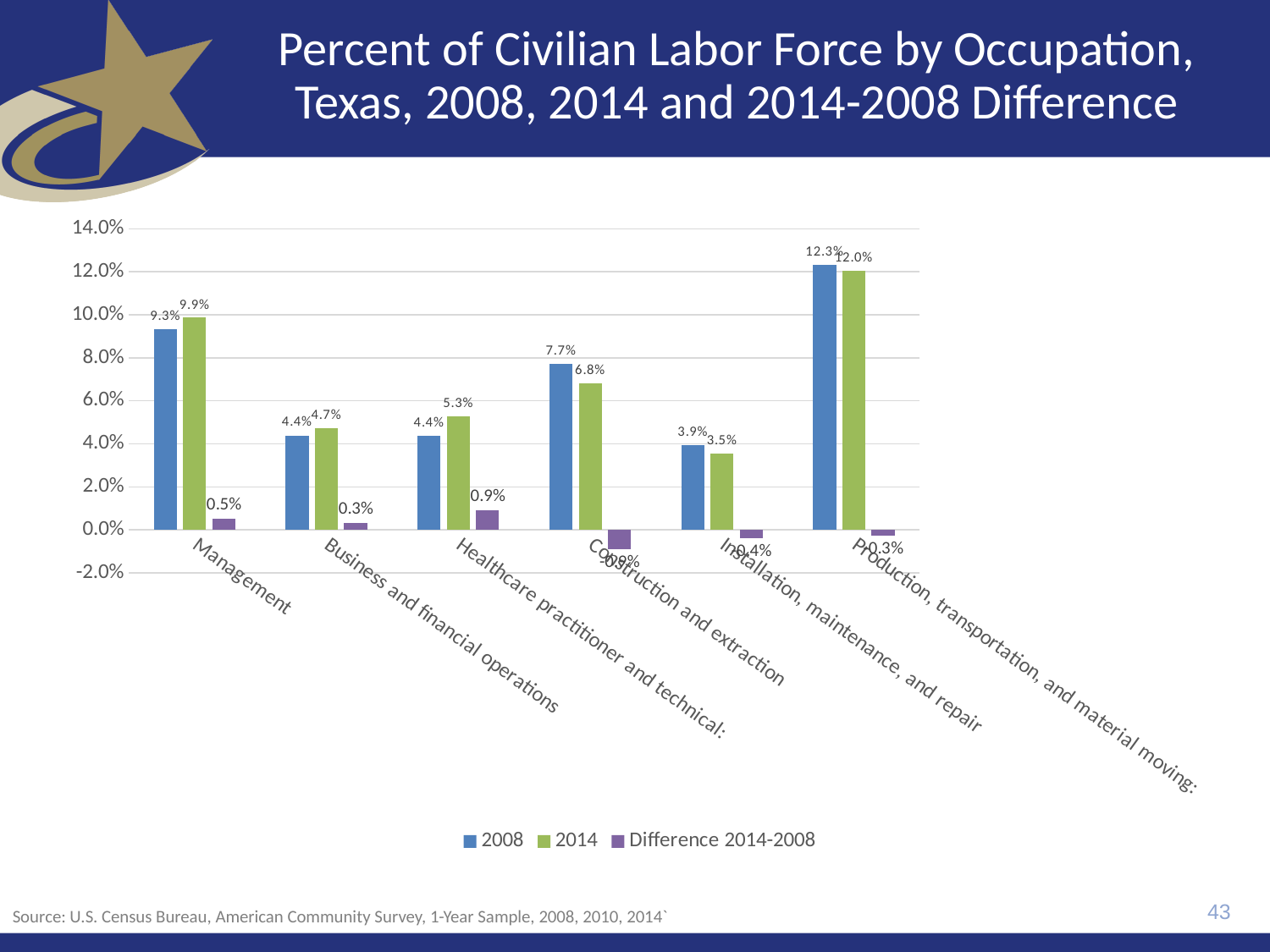
Which occupation has the highest 2014 value? Production, transportation, and material moving What is the Difference 2014-2008 value for Management? 0.5% What is the difference between the 2008 and 2014 values for Construction and extraction? 0.9% What kind of chart is shown on the slide? Bar chart Is the 2008 value for Production, transportation, and material moving greater or less than 12.0%? greater What was the 2014 value for Construction and extraction? 6.8% Which occupation has the lowest 2008 value? Installation, maintenance, and repair How many occupation categories are shown on the chart? 6 Which is larger for Installation, maintenance, and repair: the 2008 value or the 2014 value? 2008 How many series does the legend list? 3 What was the 2008 value for Management? 9.3% What was the 2014 value for Healthcare practitioner and technical? 5.3%